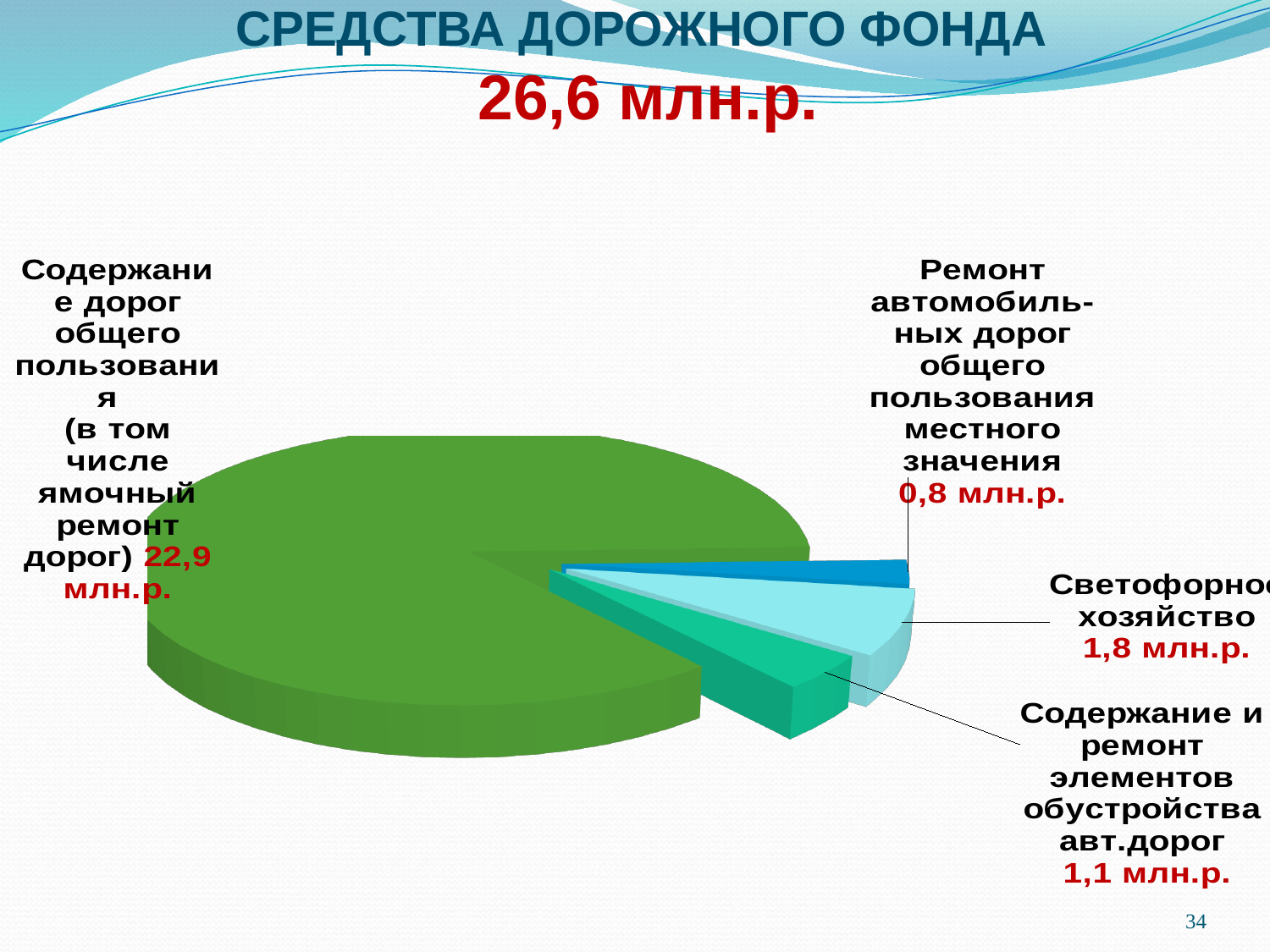
Which is larger: Светофорное хозяйство or Содержание и ремонт элементов обустройства авт.дорог? Светофорное хозяйство What is the total amount of the road fund shown in the slide title? 26,6 млн.р. Which category has the smallest slice of the pie? Ремонт автомобильных дорог общего пользования местного значения What kind of chart is shown on the slide? Pie chart What is the value for Ремонт автомобильных дорог общего пользования местного значения? 0,8 млн.р. What is the difference between Светофорное хозяйство and Содержание и ремонт элементов обустройства авт.дорог? 0,7 млн.р. What is the value for Светофорное хозяйство? 1,8 млн.р. How many slices does the pie chart have? 4 What is the value for Содержание и ремонт элементов обустройства авт.дорог? 1,1 млн.р. What is the value for Содержание дорог общего пользования (в том числе ямочный ремонт дорог)? 22,9 млн.р. Which category has the largest slice of the pie? Содержание дорог общего пользования (в том числе ямочный ремонт дорог) What is the difference between Содержание дорог общего пользования and Светофорное хозяйство? 21,1 млн.р.